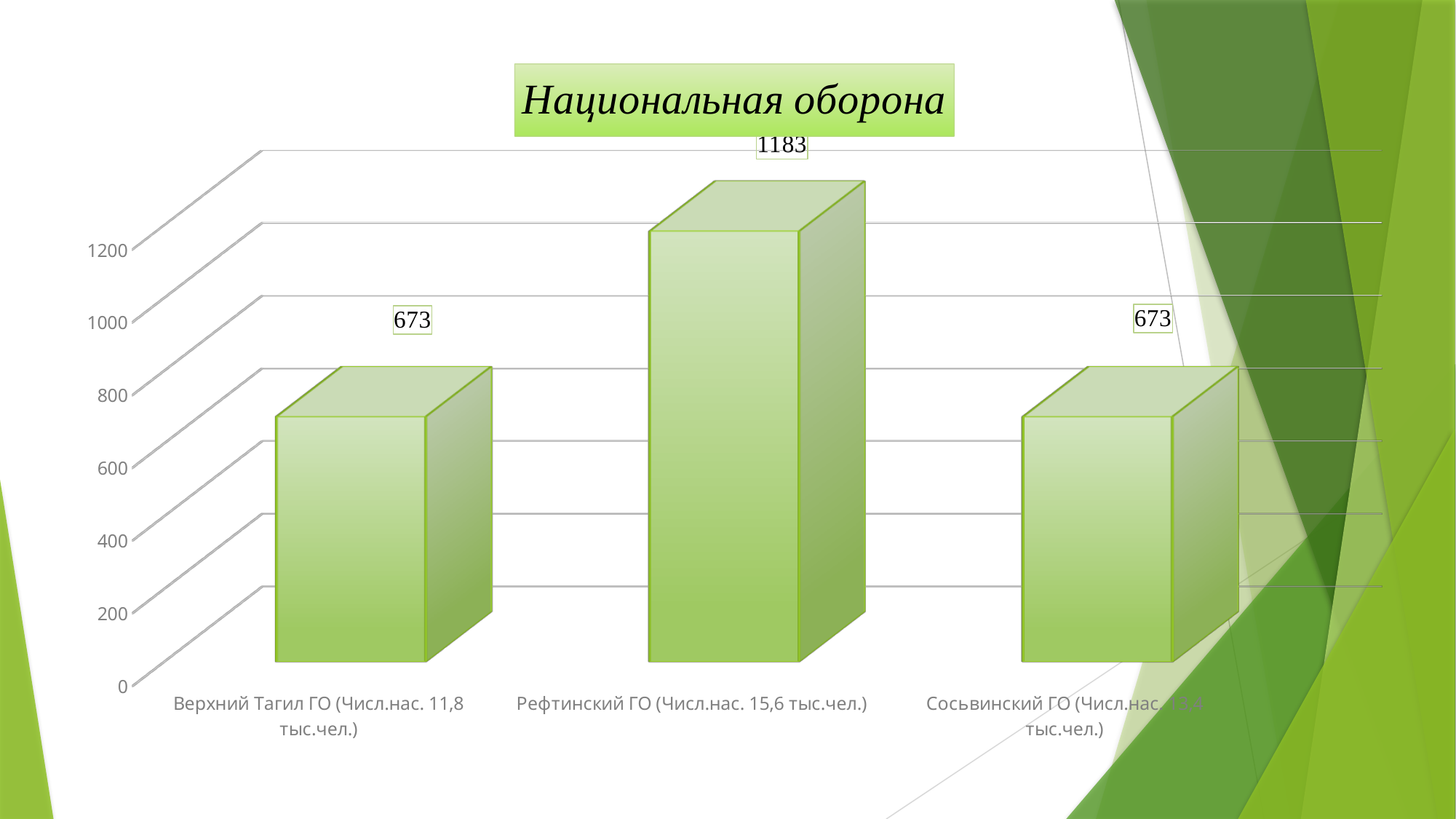
What is the title of the chart? Национальная оборона What is the value for Рефтинский ГО? 1183 What is the population given in the label for Рефтинский ГО? 15,6 тыс.чел. Which category has the highest value? Рефтинский ГО What is the difference between the values for Рефтинский ГО and Верхний Тагил ГО? 510 What kind of chart is shown on the slide? bar chart What is the value for Сосьвинский ГО? 673 Is the value for Верхний Тагил ГО greater or less than 800? less Which is larger, the value for Рефтинский ГО or the value for Сосьвинский ГО? Рефтинский ГО Is the value for Рефтинский ГО greater or less than 1000? greater How many categories are shown in the chart? 3 What is the value for Верхний Тагил ГО? 673